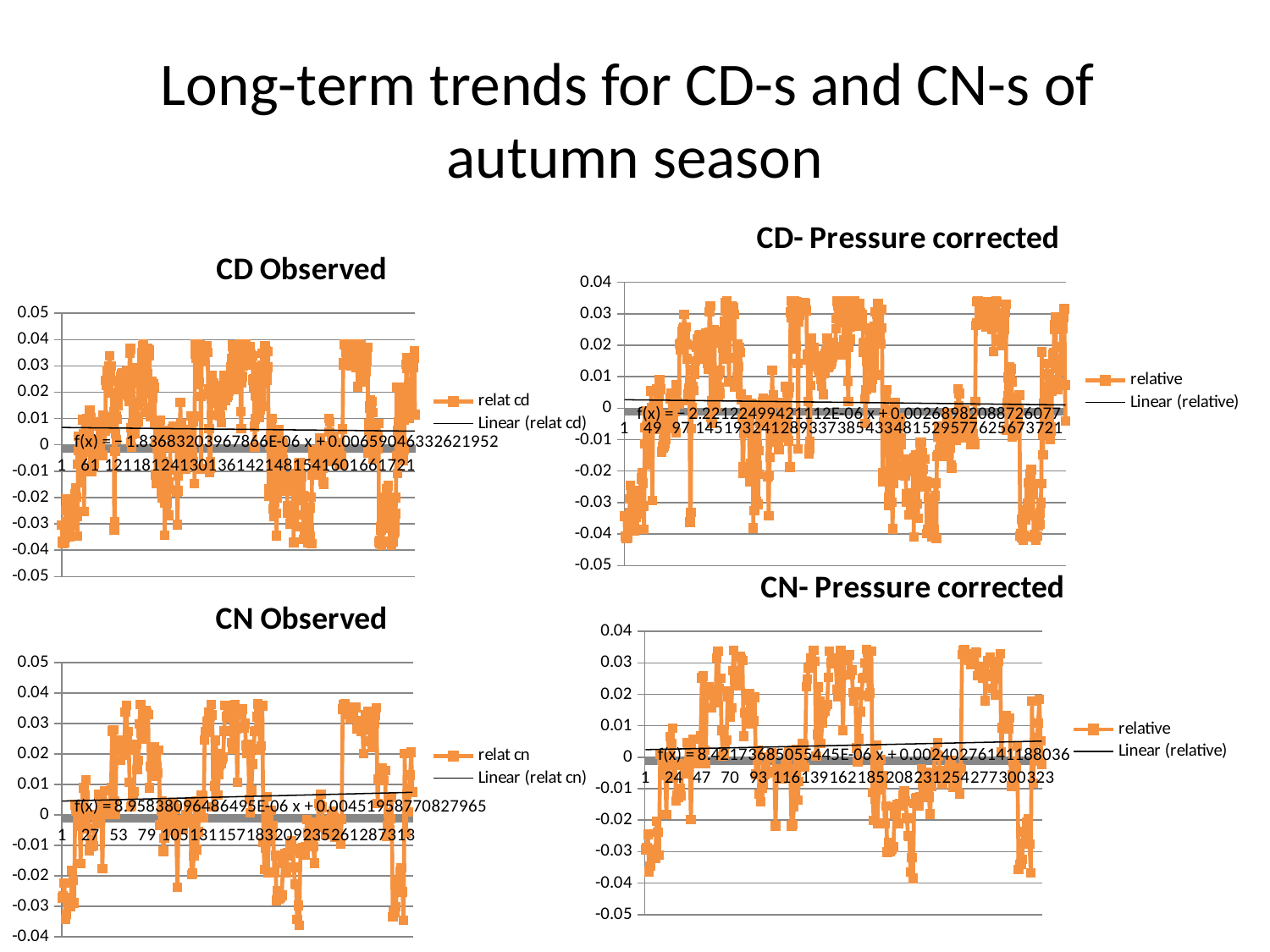
In the CN Observed chart, what is the name of the plotted data series in the legend? relat cn In the CD- Pressure corrected chart, does the linear trendline rise or fall along the x axis? fall What are the two legend entries in the CD- Pressure corrected chart? relative, Linear (relative) How many charts are shown on the slide? 4 In the CN- Pressure corrected chart, does the linear trendline rise or fall along the x axis? rise What kind of chart is the CD Observed chart? line chart In the CD Observed chart, how many entries does the legend list? 2 In the CD Observed chart, does the linear trendline rise or fall along the x axis? fall In the CN- Pressure corrected chart, is the lowest value of the relative series greater or less than -0.05? greater In the CD Observed chart, is the highest value of relat cd greater or less than 0.05? less In the CD Observed chart, what is the intercept (constant term) of the printed trendline equation? 0.00659046332621952